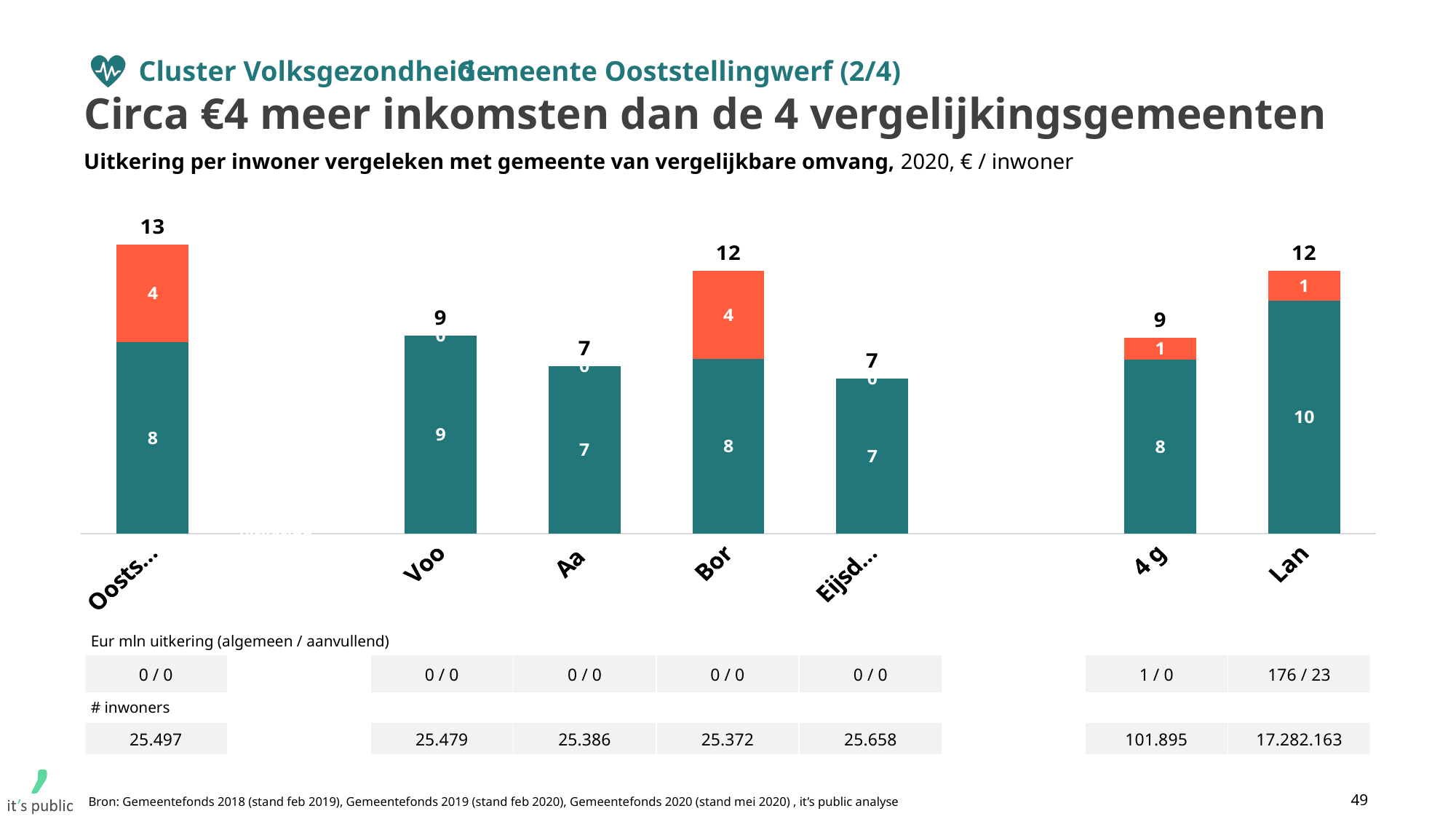
Which category has the highest total value? Oosts... What is the value of the orange (top) segment of the bar for Bor? 4 What is the total of the stacked bar for Lan (teal 10 plus orange 1)? 12 What is the value of the teal (bottom) segment of the bar for Lan? 10 How many bars (categories) are shown in the chart? 7 What is the difference between the total for Oosts... and the total for Aa? 6 What is the number of inhabitants (# inwoners) listed under Oosts...? 25.497 What is the total value shown above the bar for 4 g? 9 What kind of chart is shown on the slide? Stacked bar chart What is the subtitle of the chart? Uitkering per inwoner vergeleken met gemeente van vergelijkbare omvang, 2020, € / inwoner What is the total value shown above the bar for Oosts...? 13 Which is larger: the total for Voo or the total for Bor? Bor